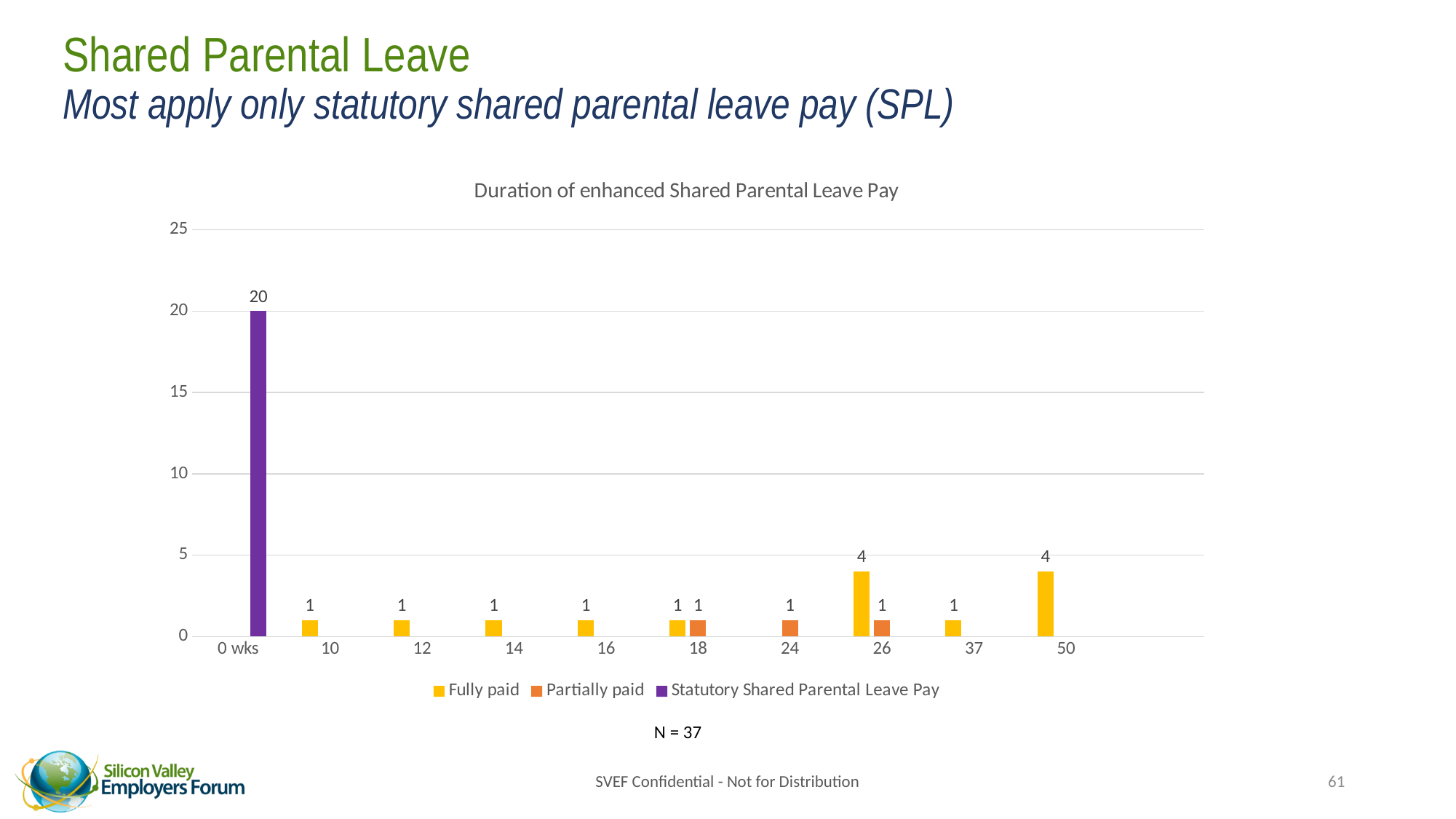
What is the title of the chart? Duration of enhanced Shared Parental Leave Pay What is the Fully paid value at 37 weeks? 1 What kind of chart is shown on the slide? Bar chart What is the value of the Statutory Shared Parental Leave Pay bar at 0 wks? 20 How many series does the legend list? 3 Which is larger: the Fully paid value at 26 weeks or the Partially paid value at 26 weeks? Fully paid How many categories are shown on the x axis? 10 Which category has the highest bar in the chart? 0 wks What is the Partially paid value at 24 weeks? 1 What is the Fully paid value at 50 weeks? 4 What is the Fully paid value at 26 weeks? 4 What is the difference between the Statutory Shared Parental Leave Pay value at 0 wks and the Fully paid value at 26 weeks? 16